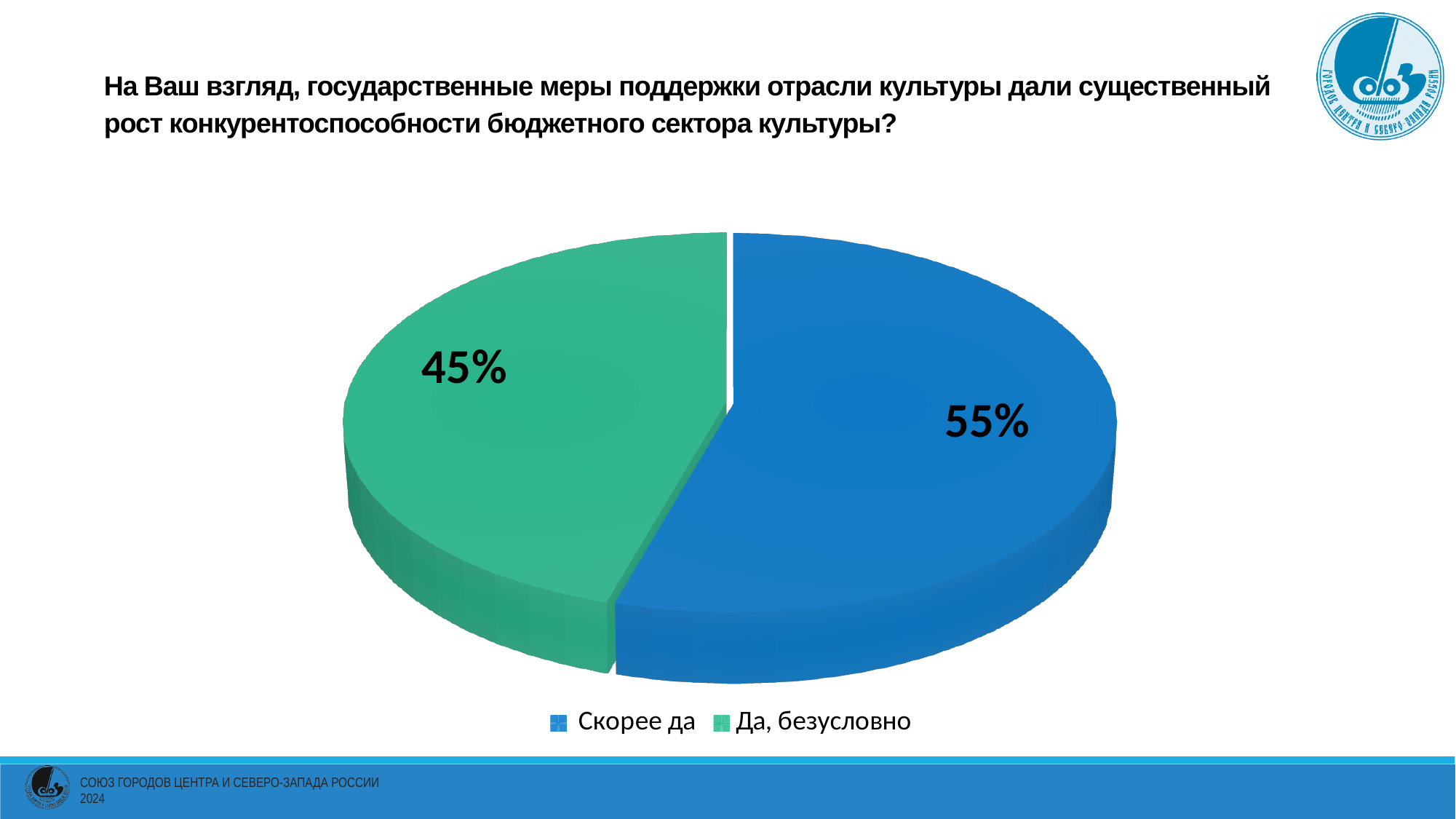
Which category has the smallest slice of the pie? Да, безусловно What colour is the slice for "Скорее да"? Blue Which category has the largest slice of the pie? Скорее да Which is larger: the share for "Скорее да" or for "Да, безусловно"? Скорее да What colour is the slice for "Да, безусловно"? Green How many categories are shown in the pie chart? 2 What share of the pie does "Да, безусловно" represent? 45% How many entries does the legend list? 2 What is the difference in percentage points between "Скорее да" and "Да, безусловно"? 10% What share of the pie does "Скорее да" represent? 55% What kind of chart is shown on the slide? Pie chart